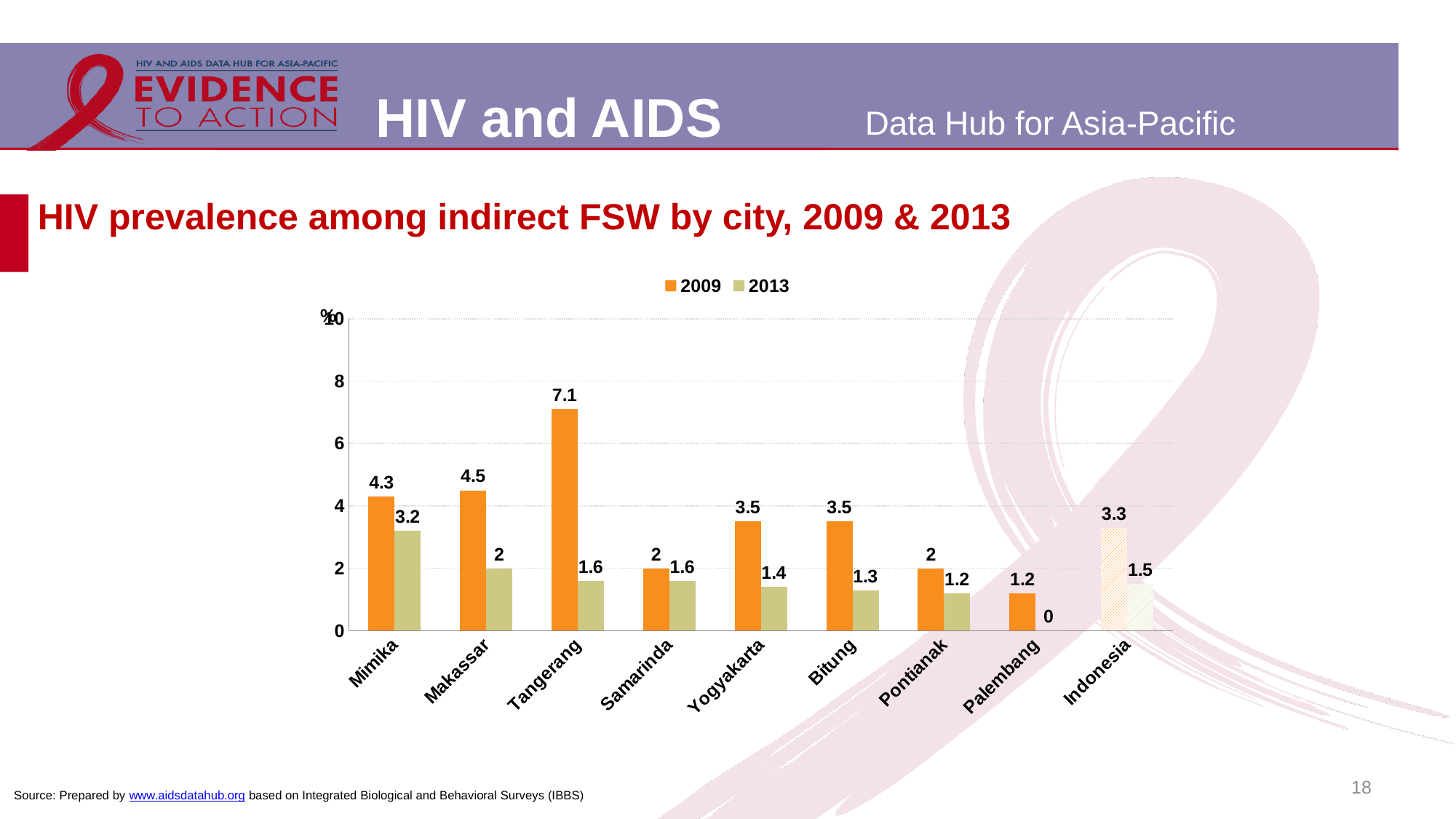
What is the 2009 HIV prevalence value for Tangerang? 7.1 What is the 2013 HIV prevalence value for Mimika? 3.2 Which category has the lowest 2013 value? Palembang What is the difference between the 2009 and 2013 values for Tangerang? 5.5 How many series does the legend list? 2 What is the 2009 value for Indonesia? 3.3 How many cities/categories are shown on the x axis? 9 What are the two series listed in the legend? 2009 and 2013 Which is larger for Makassar: the 2009 value or the 2013 value? 2009 What kind of chart is shown on the slide? Bar chart What is the 2013 value for Palembang? 0 Which city has the highest 2009 HIV prevalence? Tangerang